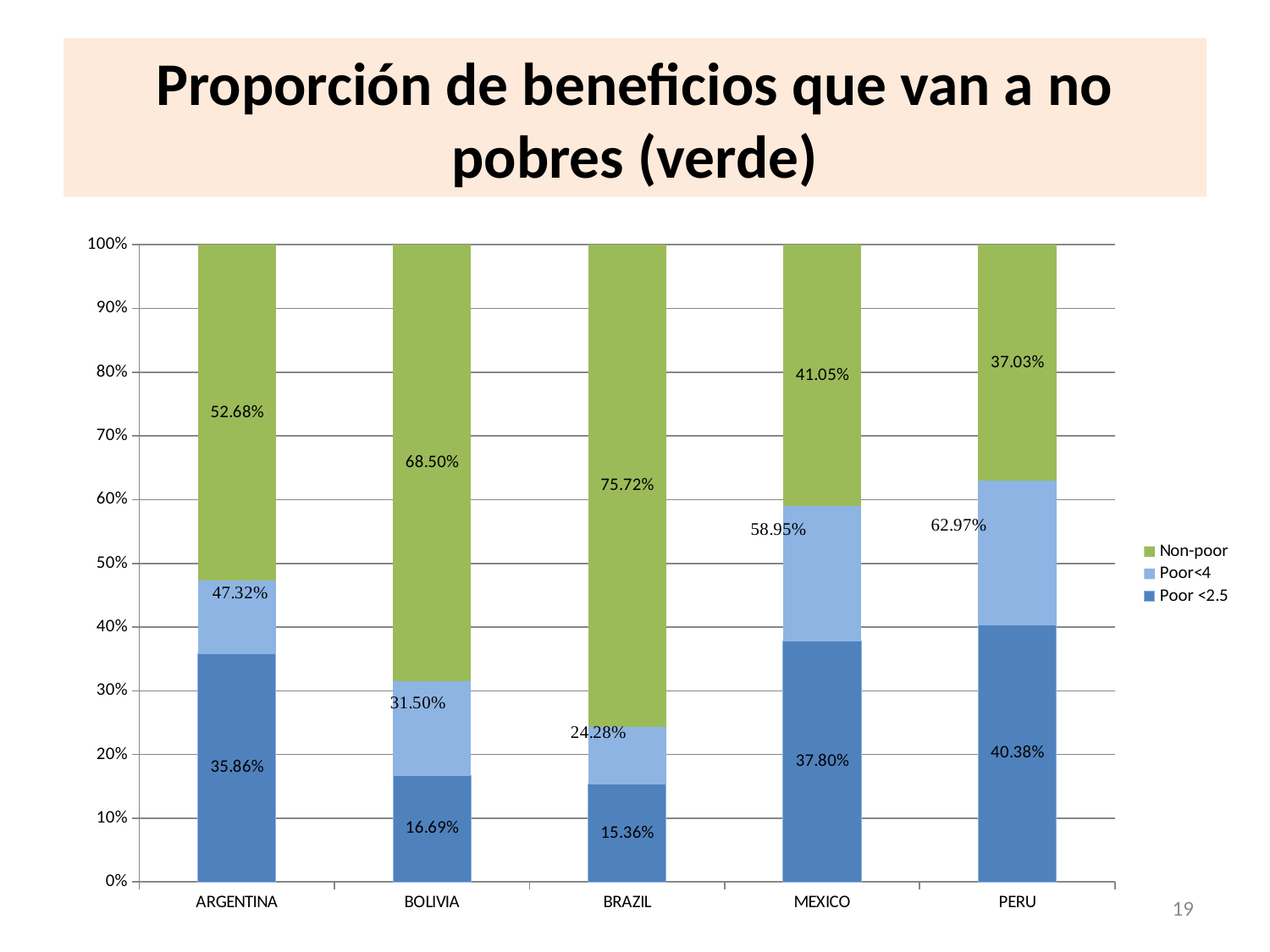
What is the Poor <2.5 value for BOLIVIA? 16.69% What is the Non-poor value for BRAZIL? 75.72% Which country has the lowest Non-poor value? PERU Which country has the highest Poor <2.5 value? PERU Which country has the highest Non-poor value? BRAZIL Which colour represents the Non-poor series in the legend? Green Which has the larger Poor <2.5 value, MEXICO or BOLIVIA? MEXICO What is the difference between the Non-poor values for BRAZIL and ARGENTINA? 23.04 percentage points What kind of chart is shown on the slide? Stacked bar chart How many countries are shown on the x axis? 5 How many series does the legend list? 3 What value is printed on the Poor<4 segment for MEXICO? 58.95%